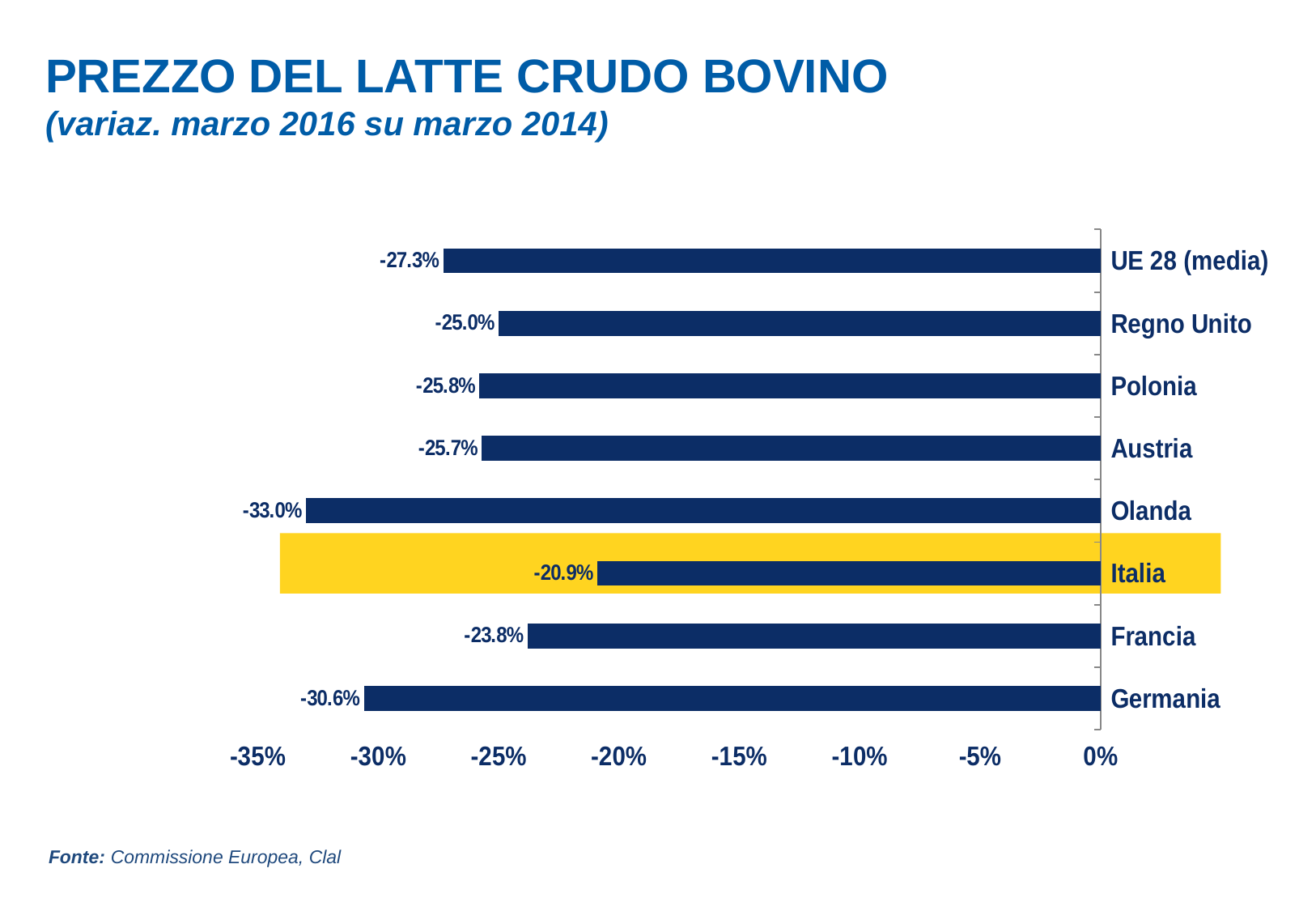
Which country shows the smallest price decline (the highest value)? Italia By how many percentage points does the decline for Olanda exceed the decline for Italia? 12.1 percentage points Is the value for Francia greater or less than -25%? greater How many countries or regions are shown in the chart? 8 Which has the larger price decline, Polonia or Regno Unito? Polonia By how many percentage points does the decline for Germania exceed the decline for Francia? 6.8 percentage points What kind of chart is shown on the slide? Bar chart What is the value shown for Olanda? -33.0% What is the value shown for Germania? -30.6% What is the value shown for Italia? -20.9% What is the value shown for UE 28 (media)? -27.3% Which country shows the largest price decline (the lowest value)? Olanda